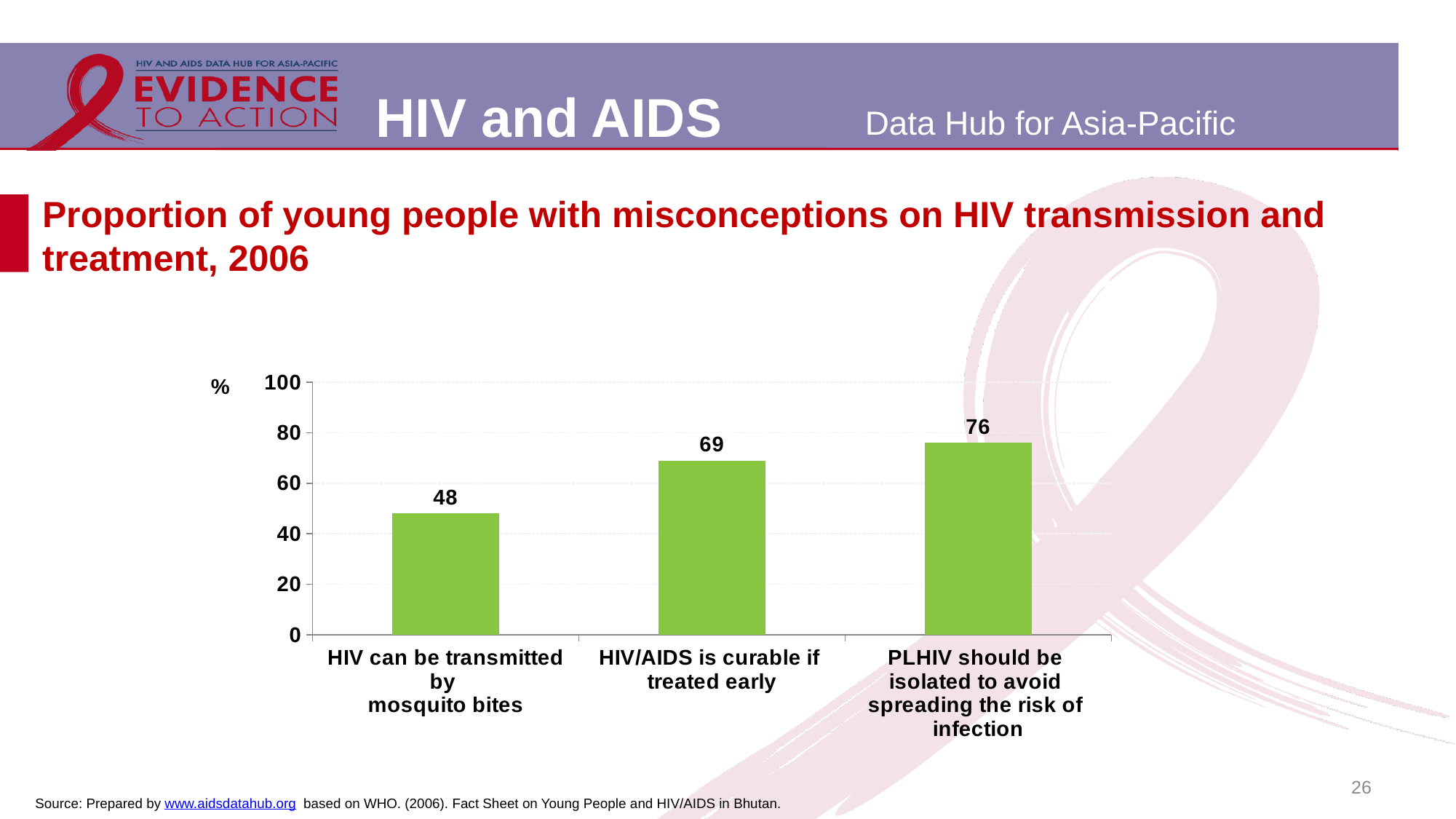
What kind of chart is shown on the slide? bar chart Is the value for 'HIV can be transmitted by mosquito bites' greater or less than 60? less What percentage of young people think PLHIV should be isolated to avoid spreading the risk of infection? 76 Which misconception has the highest proportion of young people? PLHIV should be isolated to avoid spreading the risk of infection How many misconception categories are shown in the chart? 3 Which misconception has the lowest proportion of young people? HIV can be transmitted by mosquito bites What is the difference between the value for 'PLHIV should be isolated' and the value for 'HIV can be transmitted by mosquito bites'? 28 Do the values rise or fall from left to right across the categories? rise What is the difference between the value for 'HIV/AIDS is curable if treated early' and the value for 'HIV can be transmitted by mosquito bites'? 21 What is the value for the misconception that HIV/AIDS is curable if treated early? 69 What percentage of young people believe HIV can be transmitted by mosquito bites? 48 Which is larger: the value for 'HIV/AIDS is curable if treated early' or the value for 'HIV can be transmitted by mosquito bites'? HIV/AIDS is curable if treated early